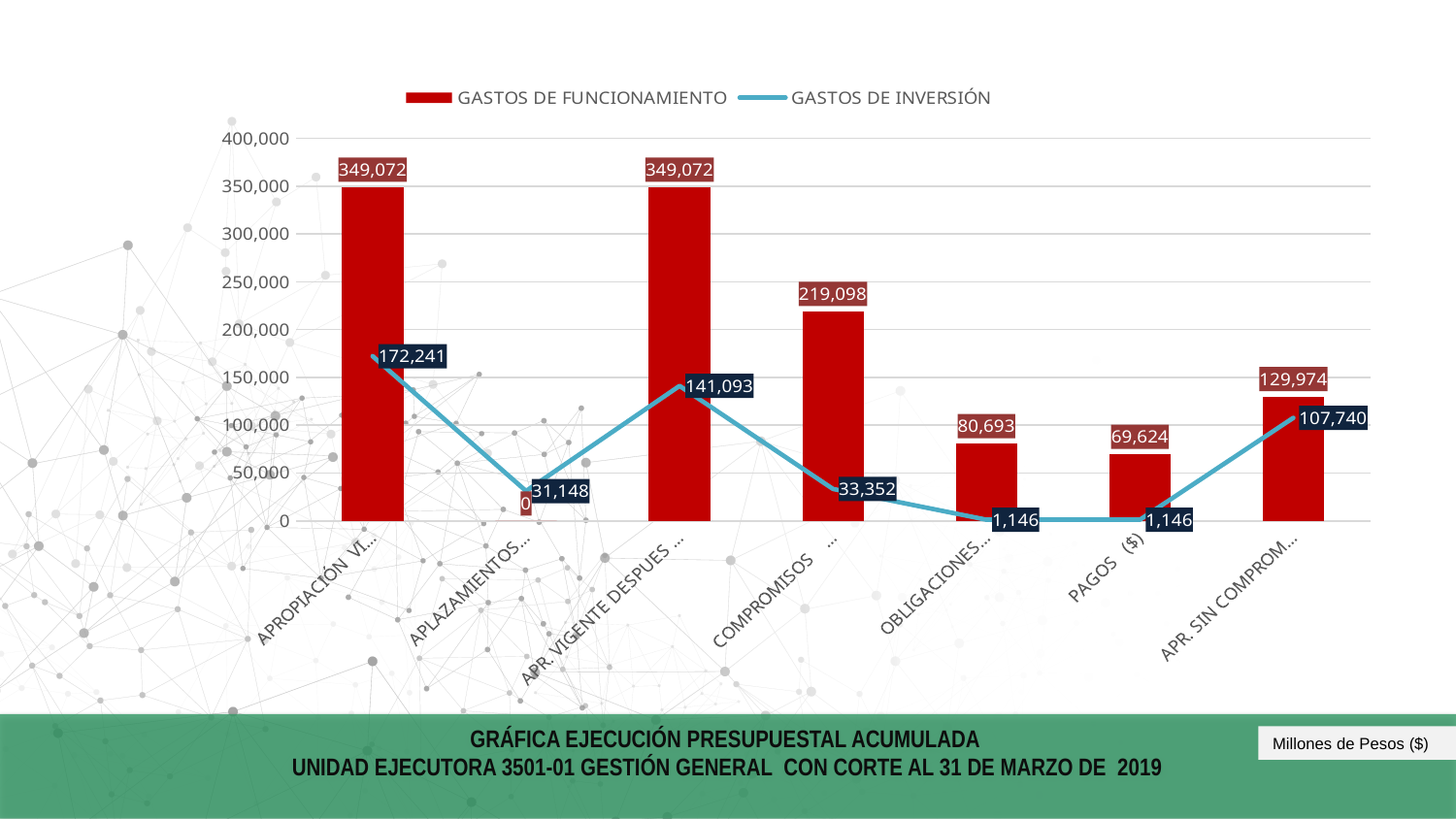
What is the difference between GASTOS DE FUNCIONAMIENTO and GASTOS DE INVERSIÓN for the PAGOS ($) category? 68,478 What kind of chart is shown on the slide? Combination bar and line chart Which category has the highest GASTOS DE INVERSIÓN value? APROPIACIÓN VI… (the first category) Which category has the lowest GASTOS DE FUNCIONAMIENTO value? APLAZAMIENTOS What is the GASTOS DE FUNCIONAMIENTO value for the COMPROMISOS category? 219,098 How many categories are shown on the x axis? 7 How many series does the legend list? 2 What is the GASTOS DE INVERSIÓN value for the APLAZAMIENTOS category? 31,148 Which is larger, the GASTOS DE FUNCIONAMIENTO value for OBLIGACIONES or for PAGOS ($)? OBLIGACIONES Does the GASTOS DE INVERSIÓN line rise or fall from COMPROMISOS to OBLIGACIONES? Fall What is the GASTOS DE INVERSIÓN value for the PAGOS ($) category? 1,146 What is the GASTOS DE FUNCIONAMIENTO value for the APR. SIN COMPROM category? 129,974